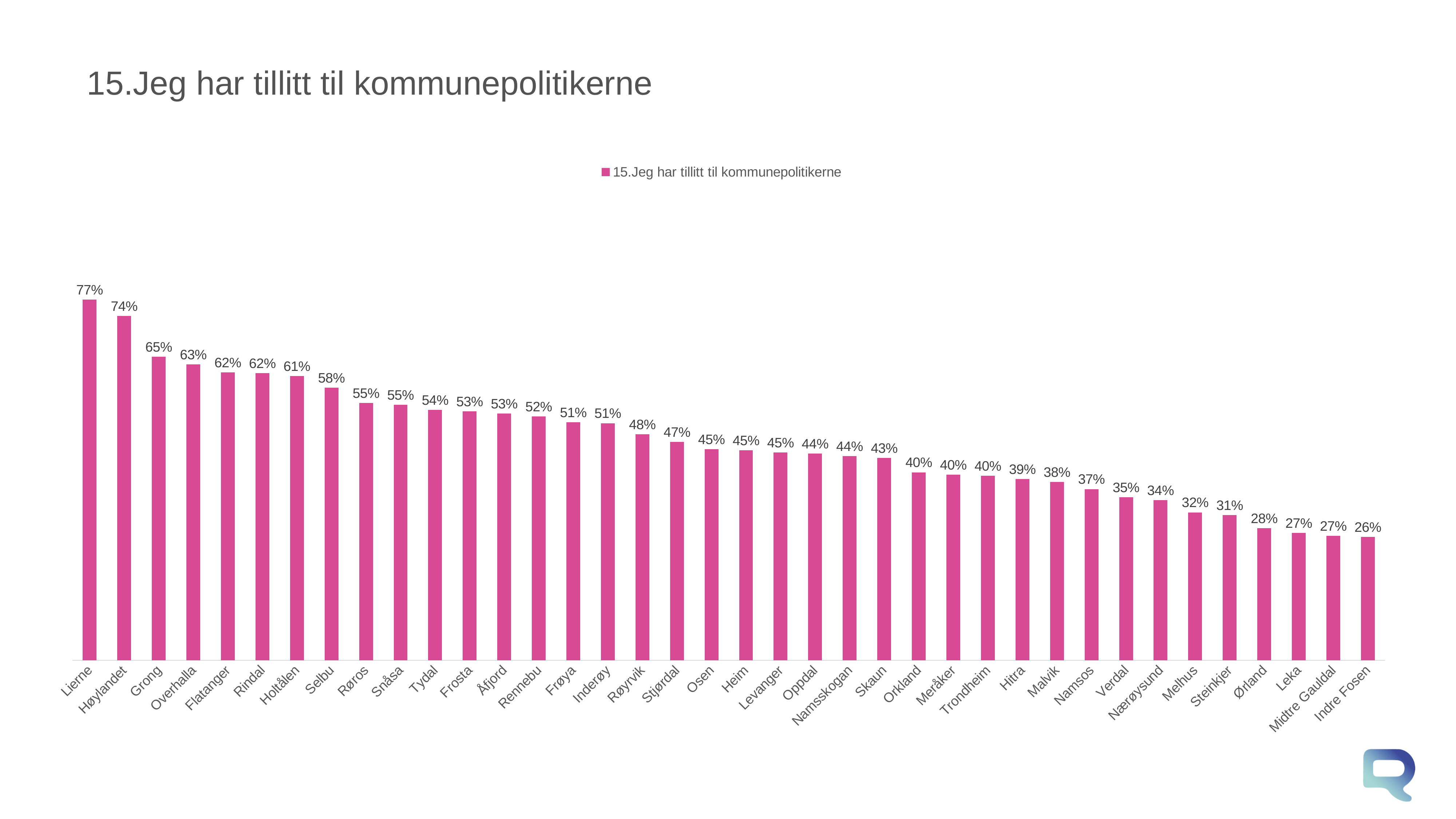
What is the value for Trondheim? 40% How many series does the legend list? 1 Which has a larger value, Selbu or Namsos? Selbu What is the value for Stjørdal? 47% What is the value for Lierne? 77% What kind of chart is shown on the slide? Bar chart Which municipality has the highest value? Lierne What is the difference between the values for Høylandet and Grong? 9% How many municipalities are shown on the x axis? 38 Do the values rise or fall from left to right along the x axis? Fall What is the difference between the values for Lierne and Indre Fosen? 51% Which municipality has the lowest value? Indre Fosen